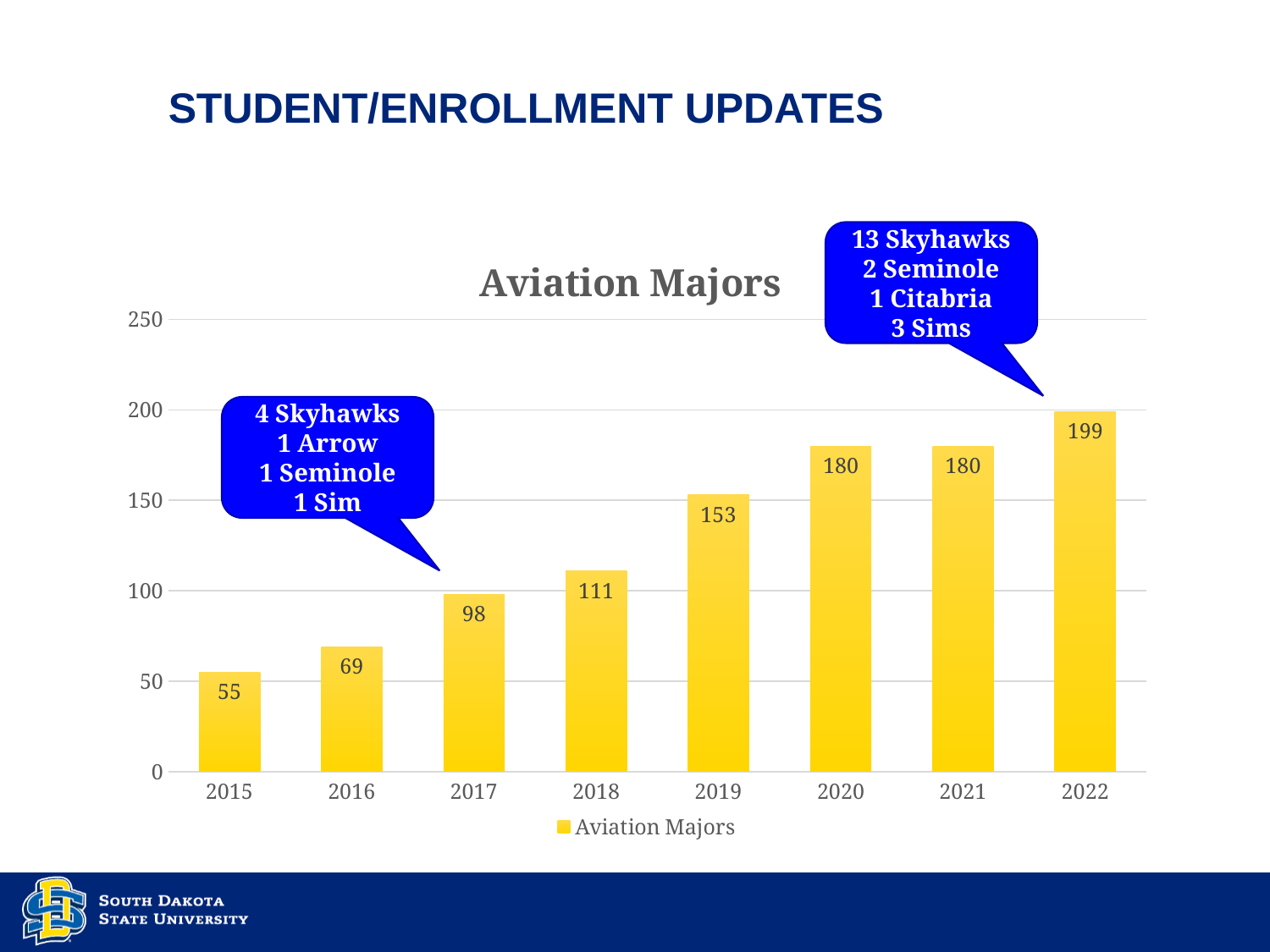
Which year has the lowest number of Aviation Majors? 2015 What is the difference in Aviation Majors between 2022 and 2015? 144 What is the difference in Aviation Majors between 2019 and 2018? 42 Do the Aviation Majors values generally rise or fall from 2015 to 2022? rise Which year has the highest number of Aviation Majors? 2022 What kind of chart is shown on the slide? bar chart What is the value for Aviation Majors in 2019? 153 How many years are shown on the x axis of the chart? 8 Which year has more Aviation Majors, 2017 or 2018? 2018 Is the value for Aviation Majors in 2020 greater or less than 150? greater What is the value for Aviation Majors in 2015? 55 What is the value for Aviation Majors in 2022? 199